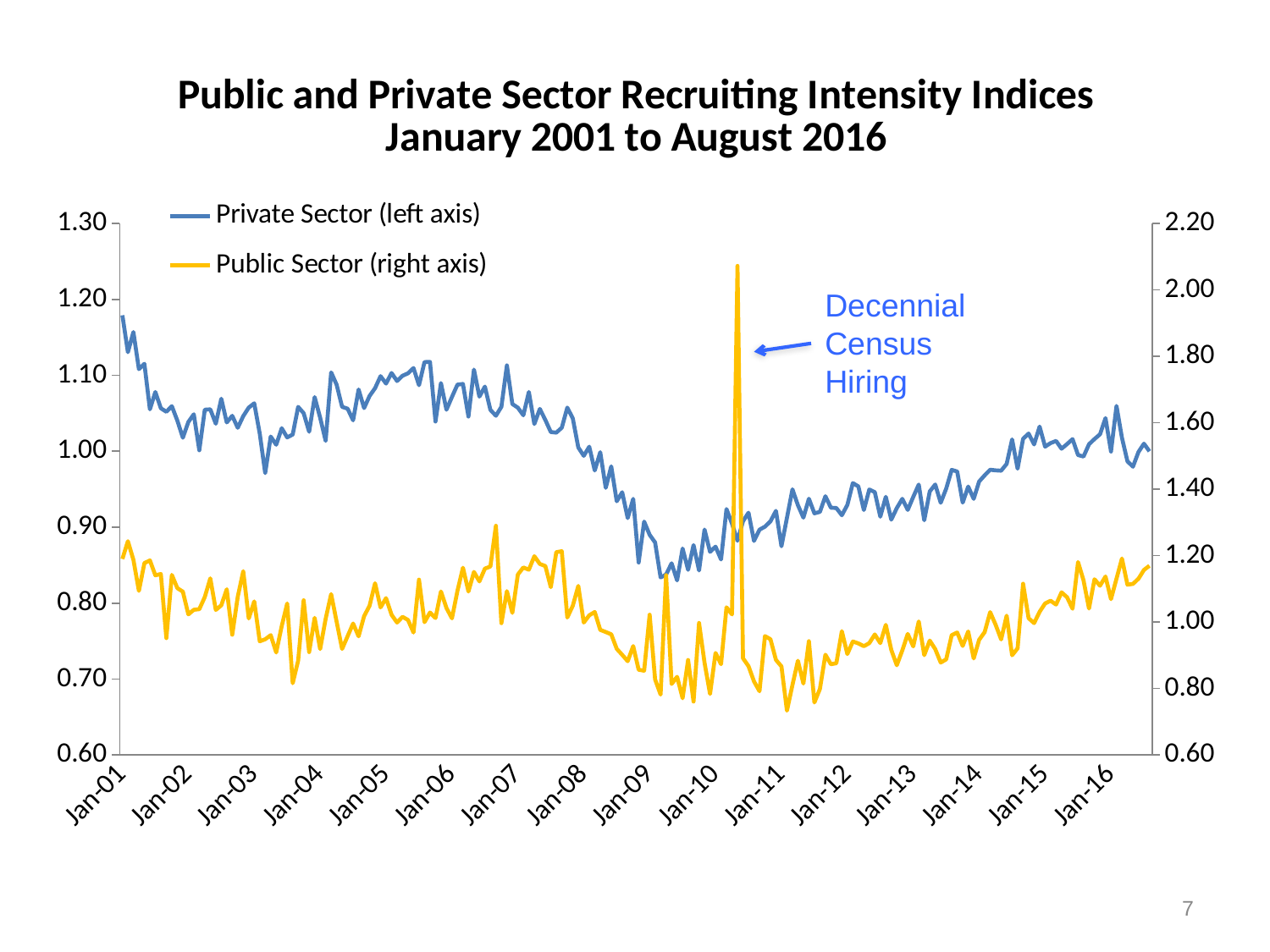
Does the Private Sector series rise or fall between Jan-10 and Jan-16? rise Which axis is the Public Sector series plotted against, according to the legend? right axis Which series shows the sharp spike labelled 'Decennial Census Hiring'? Public Sector What is the title of the chart? Public and Private Sector Recruiting Intensity Indices January 2001 to August 2016 Is the lowest Private Sector value, reached around 2009, greater or less than 0.90? less How many series does the legend list? 2 Is the Private Sector value at Jan-01 greater or less than 1.10? greater Does the Private Sector series rise or fall between Jan-06 and Jan-09? fall Is the peak of the Public Sector spike in 2010 greater or less than 2.00 on the right axis? greater What kind of chart is shown on the slide? line chart